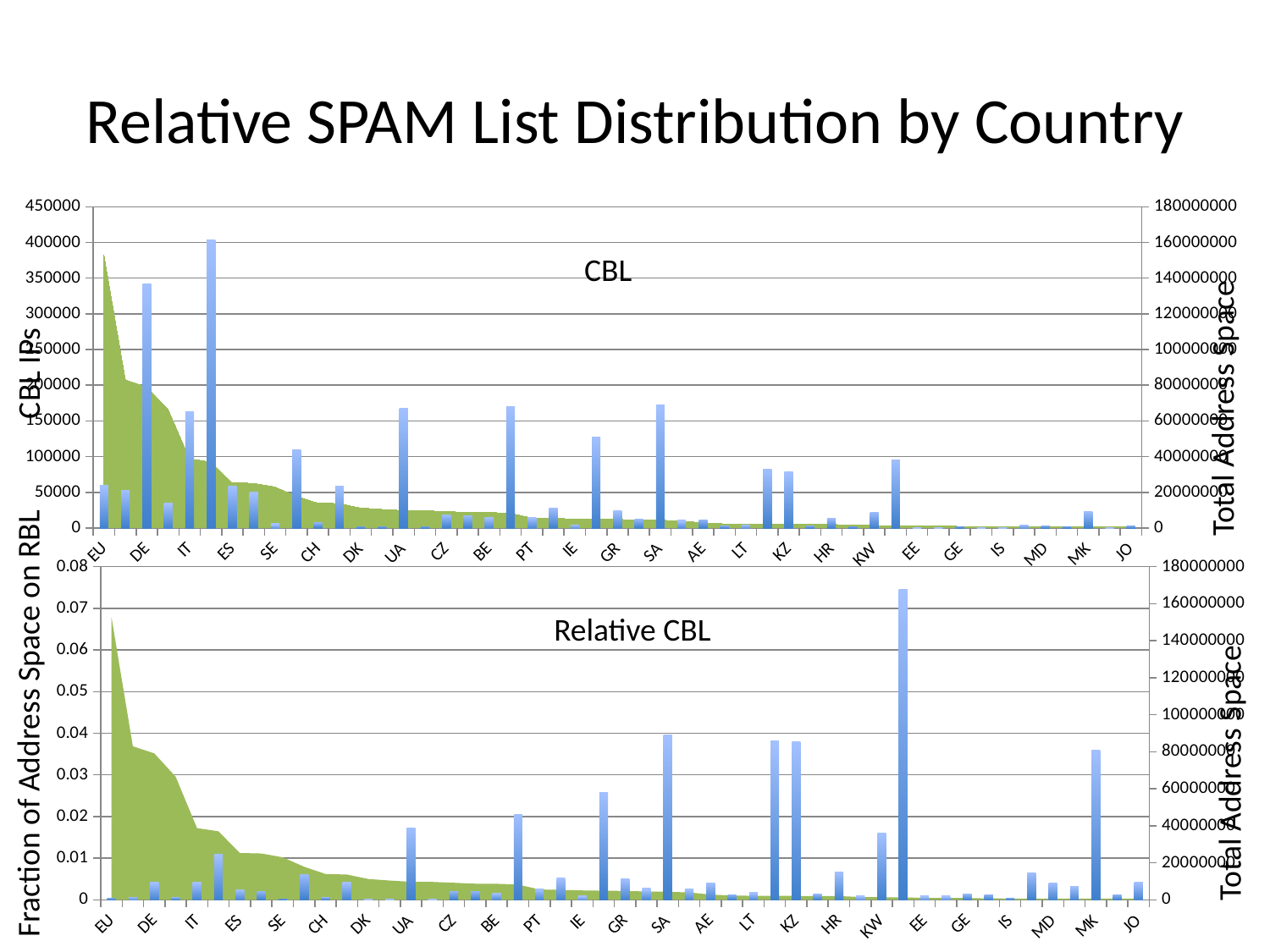
What kind of chart is the top chart titled CBL? combination area and bar chart In the top chart (CBL), does the green area series rise or fall from left to right along the x axis? fall In the bottom chart (Relative CBL), is the bar for SA greater or less than 0.03? greater In the top chart (CBL), is the bar for KZ greater or less than 100000? less In the bottom chart (Relative CBL), is the bar for MK greater or less than 0.03? greater What is the title of the left vertical axis of the bottom chart? Fraction of Address Space on RBL What is the title of the left vertical axis of the top chart? CBL IPs In the bottom chart (Relative CBL), which has the taller bar, SA or GR? SA In the top chart (CBL), which has the taller bar, DE or UA? DE